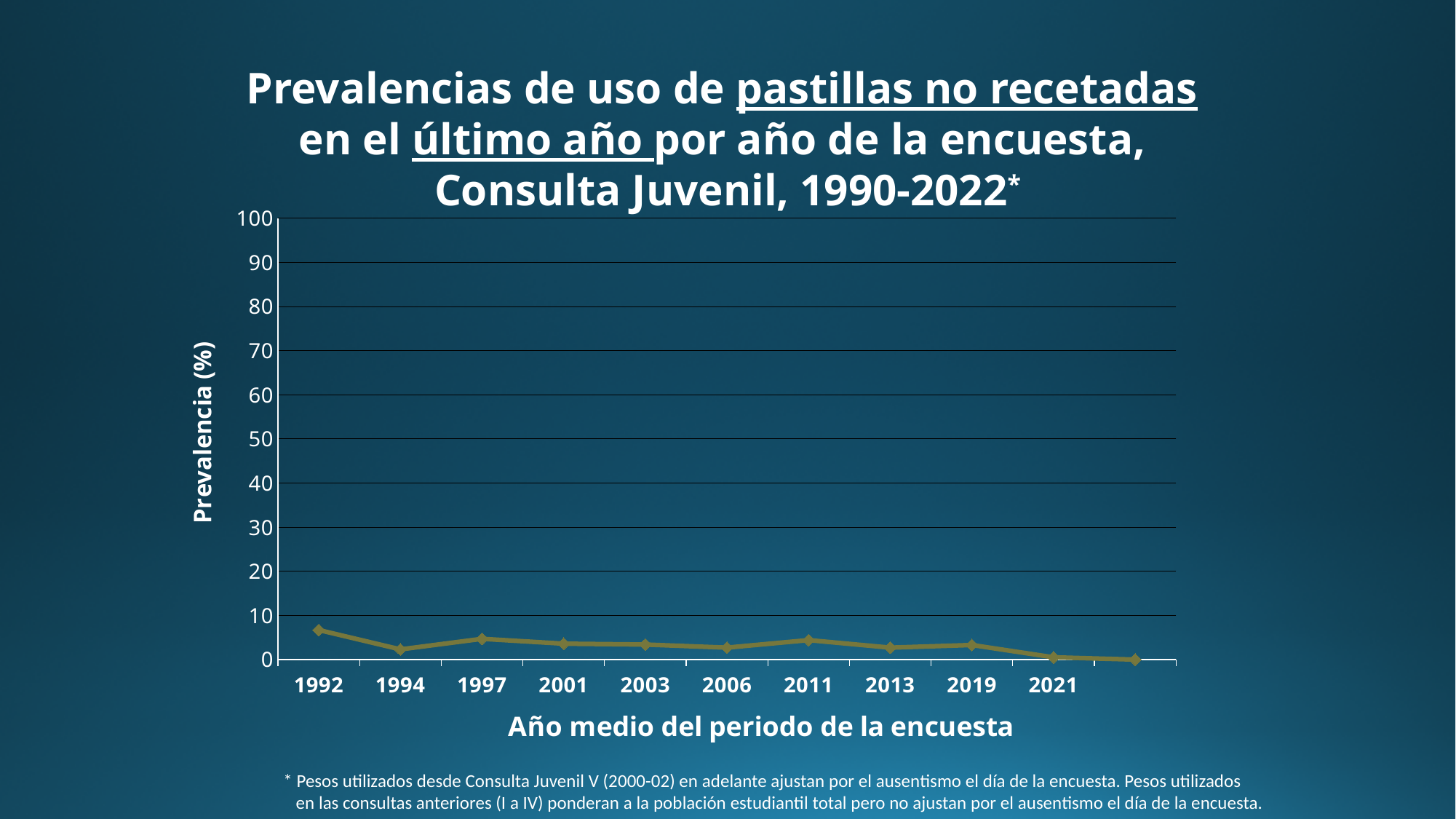
Which year has the highest prevalence value in the chart? 1992 What is the highest tick value shown on the y axis? 100 What kind of chart is shown on the slide? line chart Is the value for 1994 greater or less than 20? less Is the value for 2011 greater or less than 10? less Which is larger, the value for 2011 or the value for 2021? 2011 Which is larger, the value for 1997 or the value for 2021? 1997 Which is larger, the value for 1992 or the value for 1994? 1992 What is the label of the y axis? Prevalencia (%) Is the value for 1992 greater or less than 10? less How many years are labeled on the x axis of the chart? 10 Overall, do the values rise or fall from 1992 to the end of the series? fall